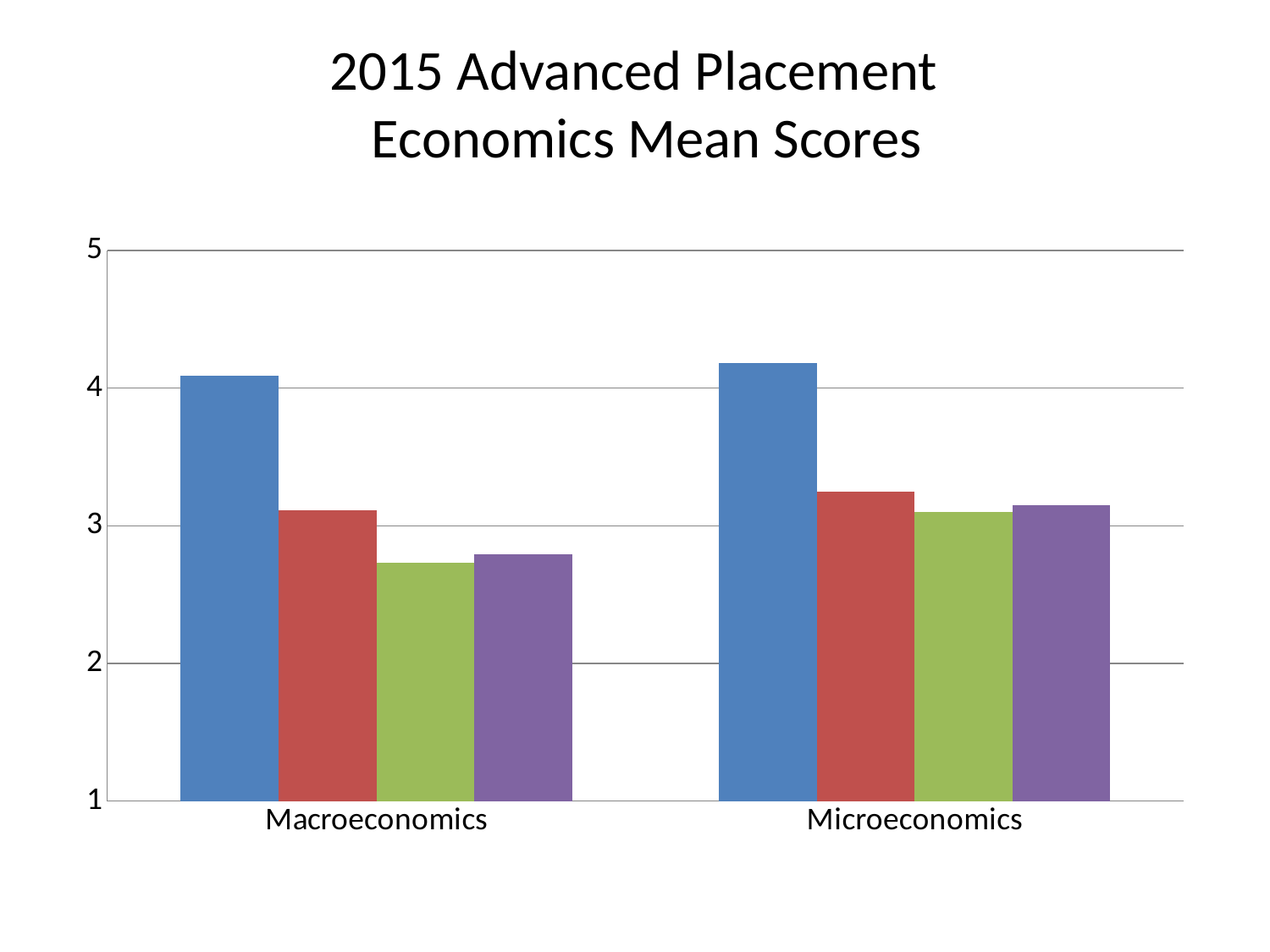
Is the value of the green bar for Macroeconomics greater or less than 3? less What is the title of the chart? 2015 Advanced Placement Economics Mean Scores Is the value of the red bar for Microeconomics greater or less than 3? greater Which bar is the tallest in the Microeconomics group? the blue bar Which is larger, the green bar for Macroeconomics or the green bar for Microeconomics? Microeconomics Is the value of the blue bar for Microeconomics greater or less than 4? greater What kind of chart is shown on the slide? bar chart Which bar is the tallest in the Macroeconomics group? the blue bar How many categories are shown on the x axis? 2 Which is larger, the red bar for Macroeconomics or the red bar for Microeconomics? Microeconomics